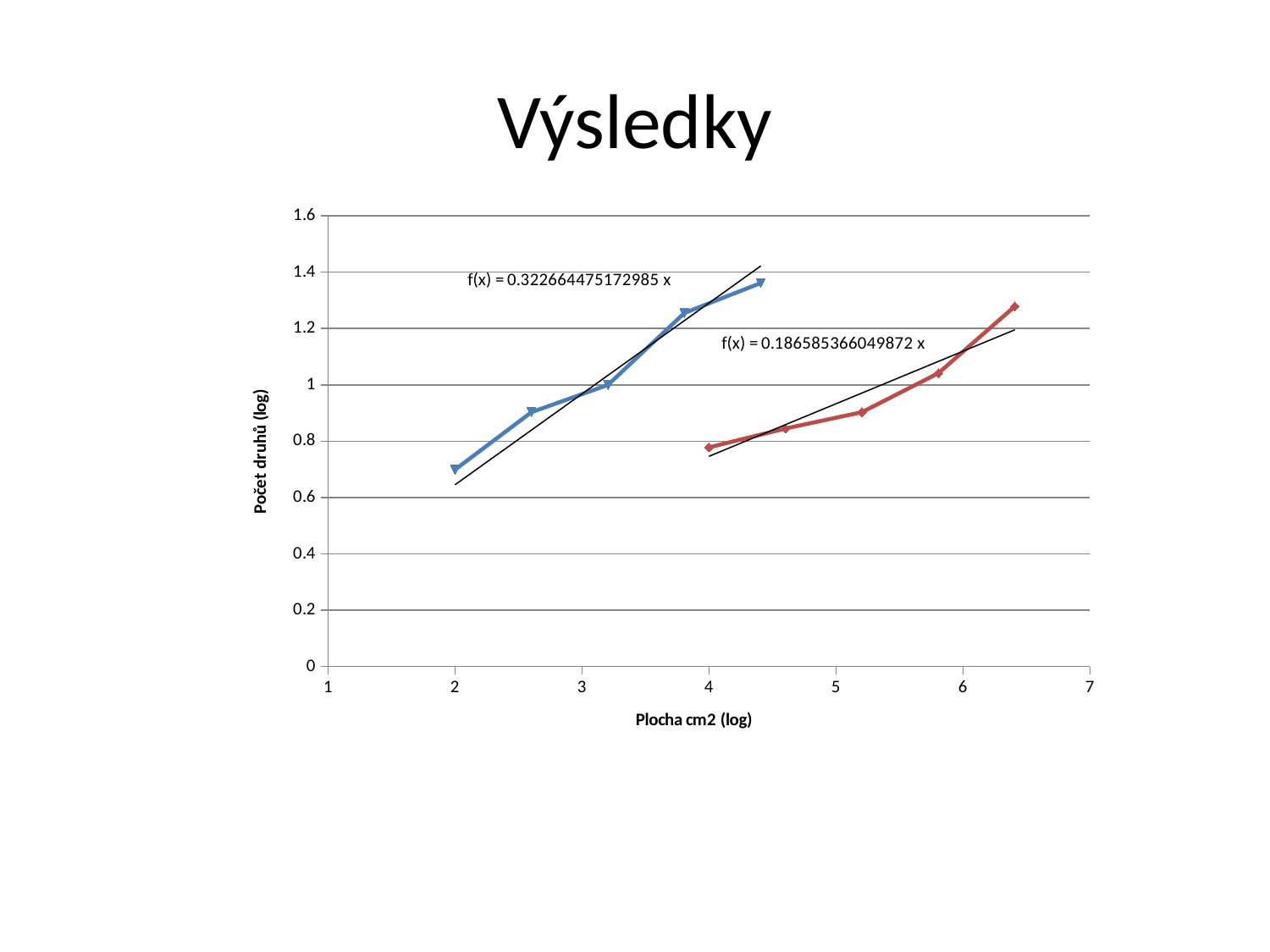
What is the title of the x axis? Plocha cm2 (log) What kind of chart is shown on the slide? line chart Which is larger: the blue series value at x = 3.8 or the red series value at x = 5.8? the blue series value at x = 3.8 What trendline equation is printed for the red series? f(x) = 0.186585366049872 x Is the value of the red series at x = 4 greater or less than 1? less Do the values of the red series rise or fall as x increases? rise Is the value of the blue series at x = 2 greater or less than 0.8? less What is the title of the y axis? Počet druhů (log) Is the value of the blue series at x = 4.4 greater or less than 1.2? greater What trendline equation is printed for the blue series? f(x) = 0.322664475172985 x How many data points does the blue series have? 5 Do the values of the blue series rise or fall as x increases? rise